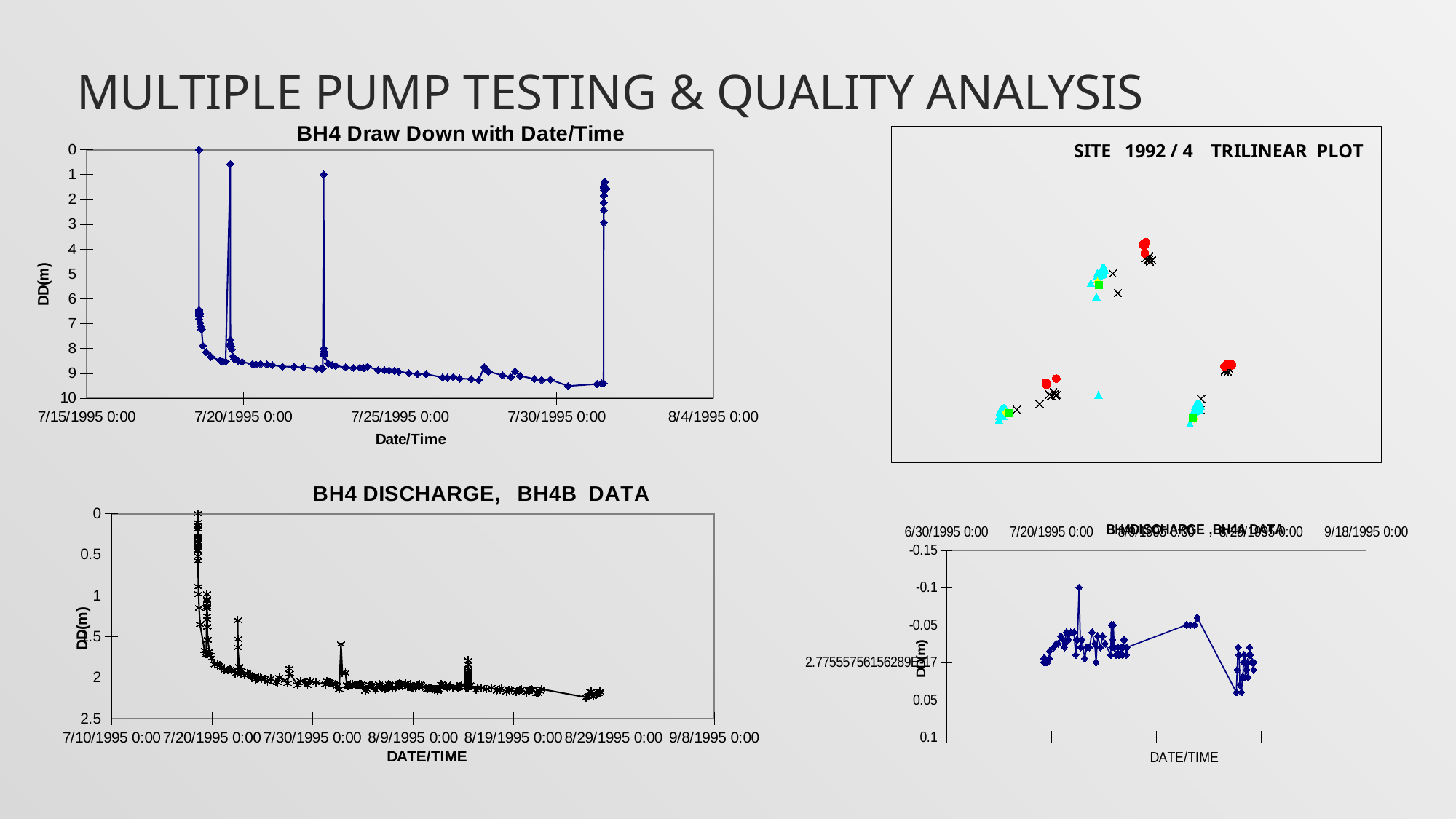
In the bottom-left chart "BH4 DISCHARGE, BH4B DATA", is the DD(m) value at 8/29/1995 0:00 greater or less than 1.5? greater What kind of chart is the top-right chart titled "SITE 1992 / 4 TRILINEAR PLOT"? scatter chart In the top-left chart "BH4 Draw Down with Date/Time", is the DD(m) value at 7/25/1995 0:00 greater or less than 4? greater In the top-left chart "BH4 Draw Down with Date/Time", is the DD(m) value at 7/30/1995 0:00 greater or less than 5? greater What is the y-axis label of the top-left chart "BH4 Draw Down with Date/Time"? DD(m) How many charts are shown on the slide? 4 What kind of chart is the bottom-left chart titled "BH4 DISCHARGE, BH4B DATA"? line chart In the bottom-left chart "BH4 DISCHARGE, BH4B DATA", does the DD(m) value generally increase or decrease between 7/20/1995 0:00 and 8/29/1995 0:00? increase What kind of chart is the top-left chart titled "BH4 Draw Down with Date/Time"? line chart What is the title of the top-right scatter chart? SITE 1992 / 4 TRILINEAR PLOT In the top-left chart "BH4 Draw Down with Date/Time", does the DD(m) value generally increase or decrease between 7/20/1995 0:00 and 7/30/1995 0:00? increase